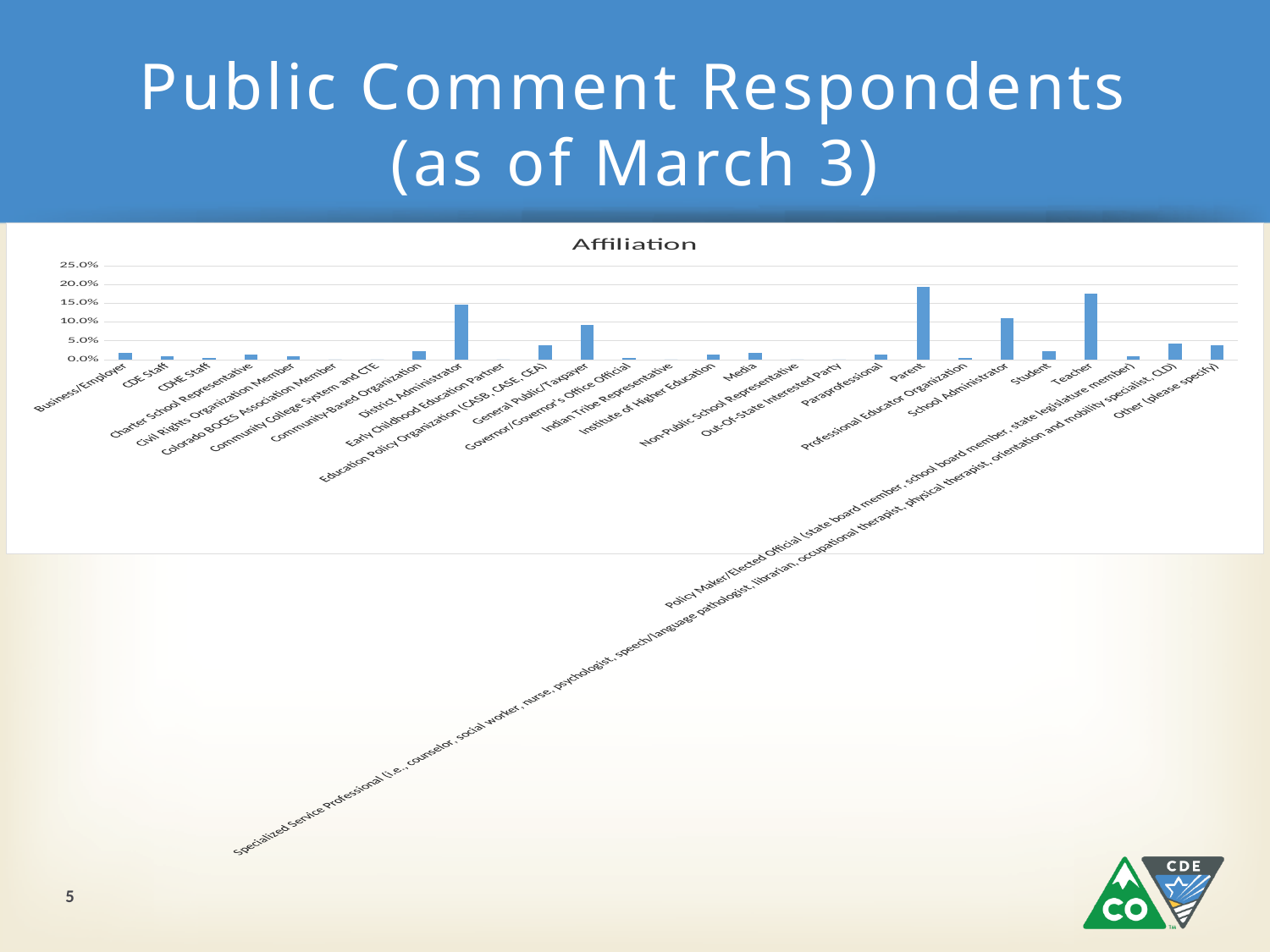
What is the highest value shown on the vertical axis? 25.0% Is the value for Parent greater or less than 15.0%? greater Is the value for Student greater or less than 5.0%? less Is the value for Teacher greater or less than 15.0%? greater Which is larger, the value for Parent or the value for Teacher? Parent Which affiliation has the highest share of respondents? Parent What kind of chart is shown on the slide? bar chart Which is larger, the value for District Administrator or the value for School Administrator? District Administrator What is the title of the chart? Affiliation